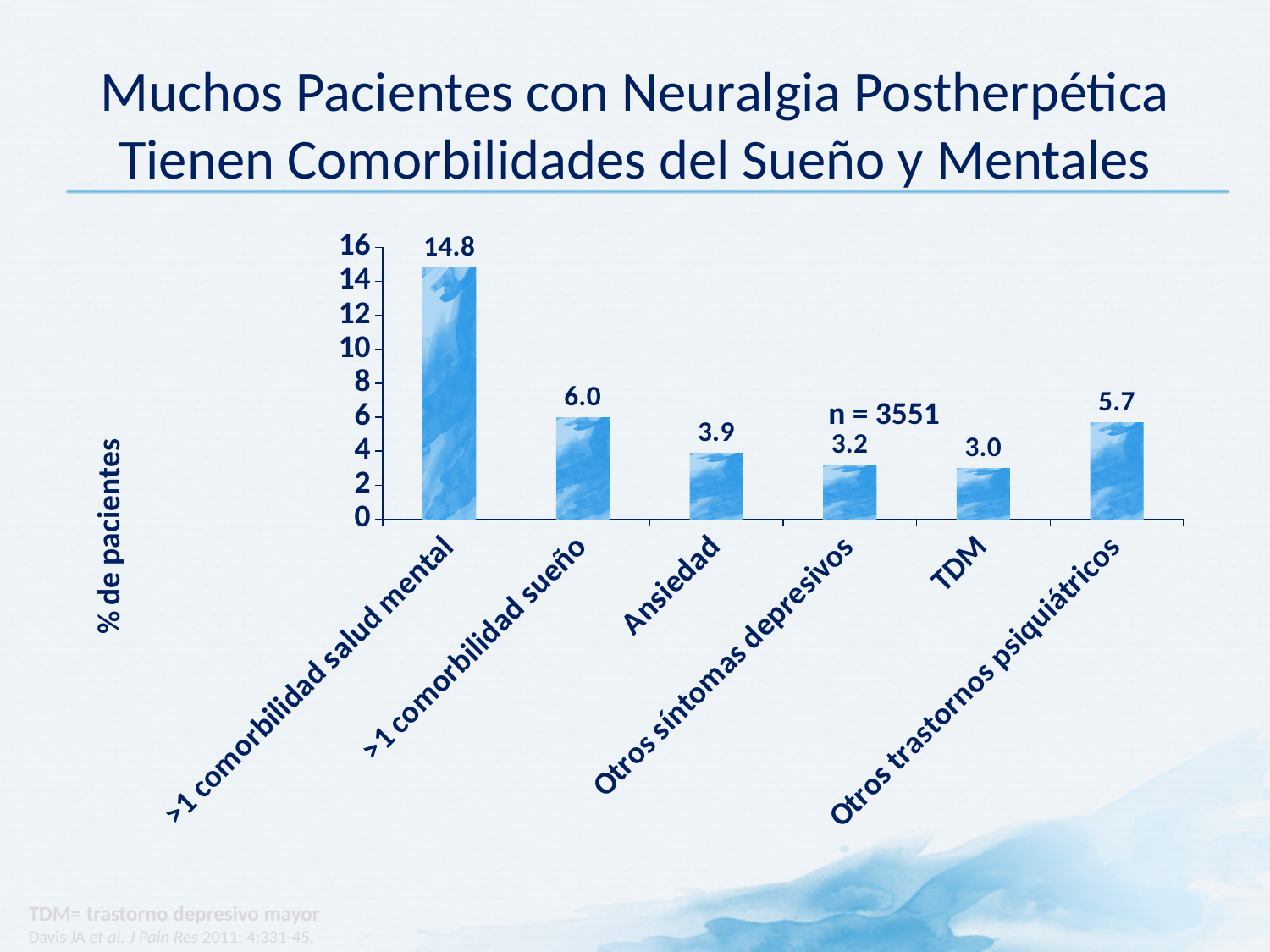
What is the difference between the values for '>1 comorbilidad salud mental' and '>1 comorbilidad sueño'? 8.8 What is the label of the y axis? % de pacientes How many categories are shown on the chart? 6 What is the value for 'Otros trastornos psiquiátricos'? 5.7 What is the value for '>1 comorbilidad salud mental'? 14.8 Which is larger, the value for 'Otros síntomas depresivos' or the value for 'Otros trastornos psiquiátricos'? Otros trastornos psiquiátricos Which category has the highest value? >1 comorbilidad salud mental What kind of chart is shown on the slide? bar chart What is the value for 'TDM'? 3.0 Is the value for '>1 comorbilidad sueño' greater or less than 8? less Which category has the lowest value? TDM What is the value for 'Ansiedad'? 3.9